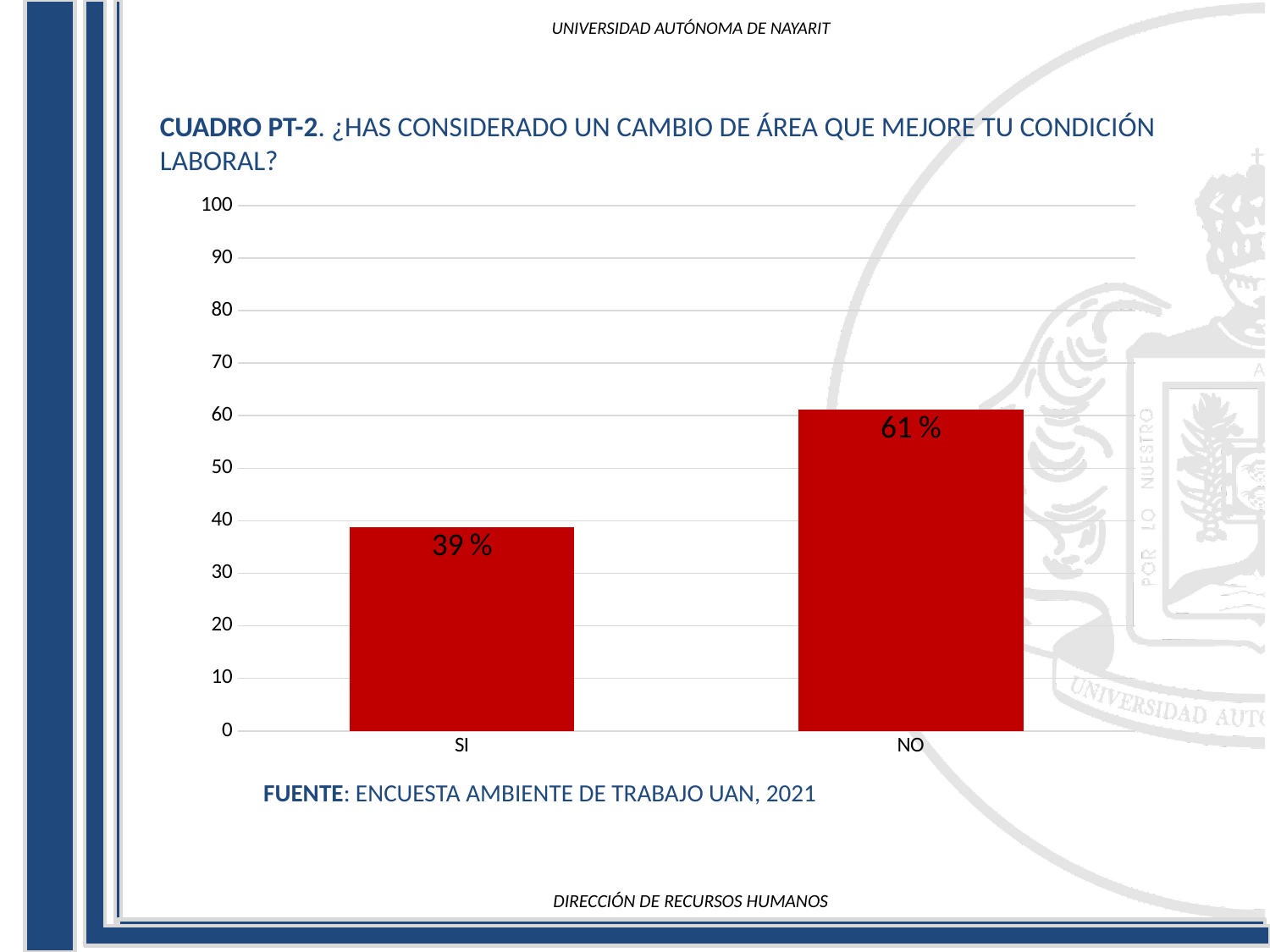
Which category has the highest value? NO Is the value for SI greater or less than 40? less Which category has the lowest value? SI What colour are the bars in the chart? red What is the value for NO? 61 % Is the value for NO greater or less than 60? greater What is the difference between the values for NO and SI? 22 % What is the value for SI? 39 % What is the highest value shown on the y axis? 100 How many categories are shown on the x axis? 2 Which is larger, the value for SI or the value for NO? NO What kind of chart is shown on the slide? bar chart